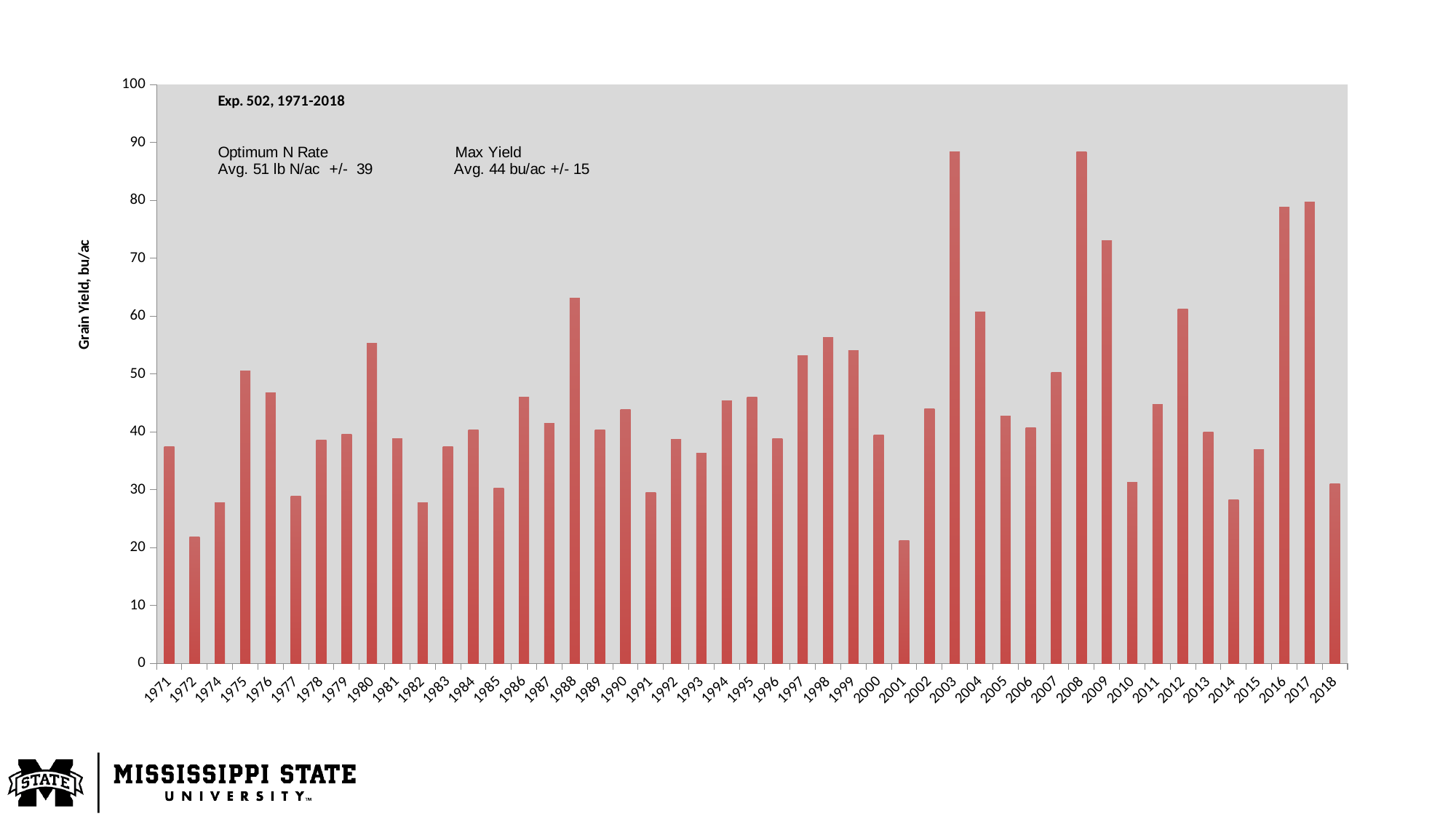
What experiment and year range does the text in the chart identify? Exp. 502, 1971-2018 Is the grain yield for 2001 greater or less than 30? less Which year has the lower grain yield, 1975 or 1977? 1977 Is the grain yield for 2014 greater or less than 30? less Which year has the higher grain yield, 1988 or 1980? 1988 What kind of chart is shown on the slide? bar chart Which year has the higher grain yield, 2009 or 2004? 2009 Is the grain yield for 2003 greater or less than 80? greater What is the label on the vertical axis of the chart? Grain Yield, bu/ac